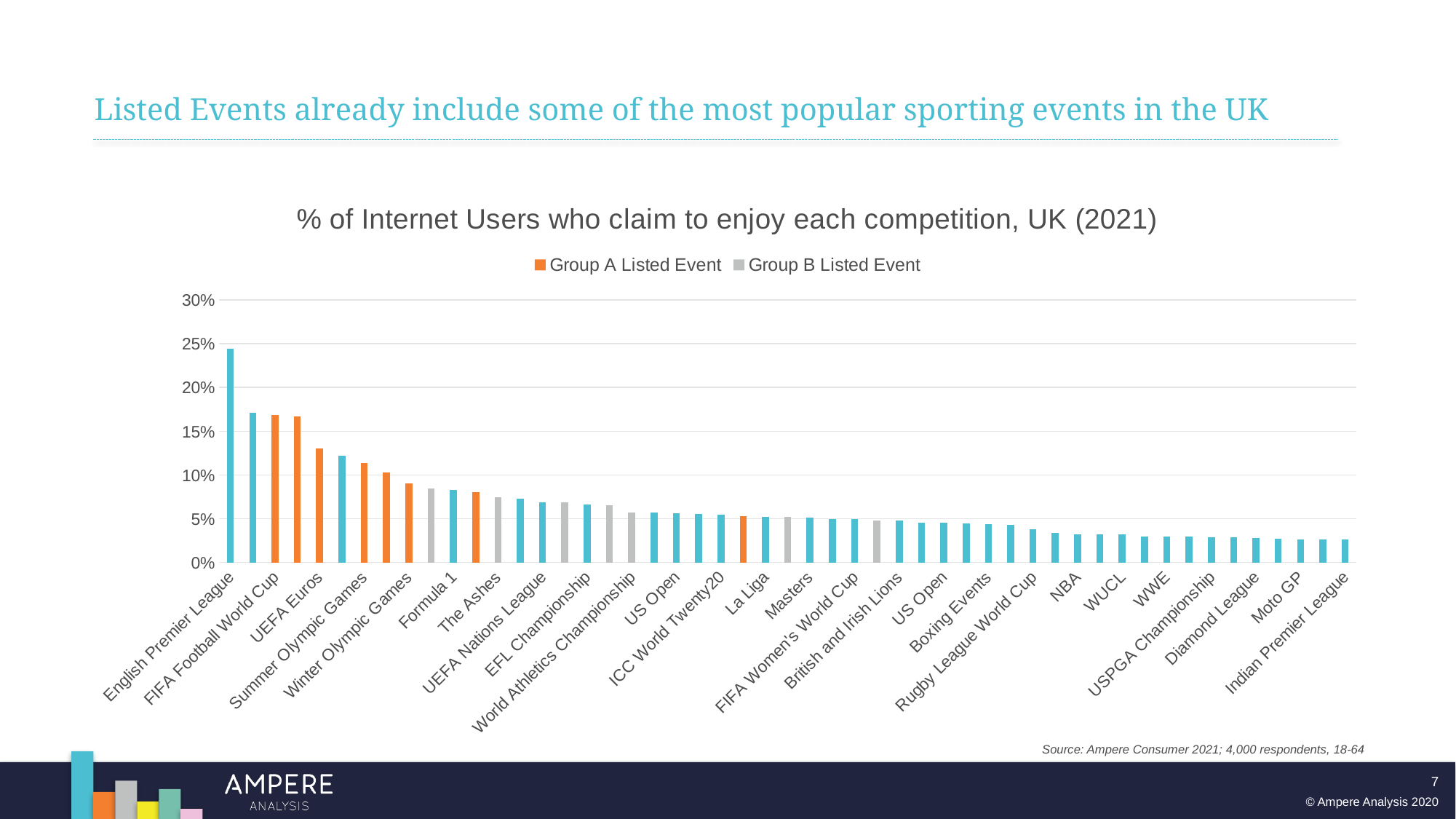
Which colour represents Group A Listed Event in the legend? Orange Is the value for UEFA Euros greater or less than 10%? greater Is the value for FIFA Football World Cup greater or less than 15%? greater What is the title of the chart? % of Internet Users who claim to enjoy each competition, UK (2021) Do the values generally rise or fall moving from left to right along the x axis? Fall Is the value for English Premier League greater or less than 20%? greater Which has a higher value, English Premier League or FIFA Football World Cup? English Premier League How many series does the chart legend list? 2 Which competition has the highest share of internet users who claim to enjoy it? English Premier League What type of chart is shown on the slide? Bar chart